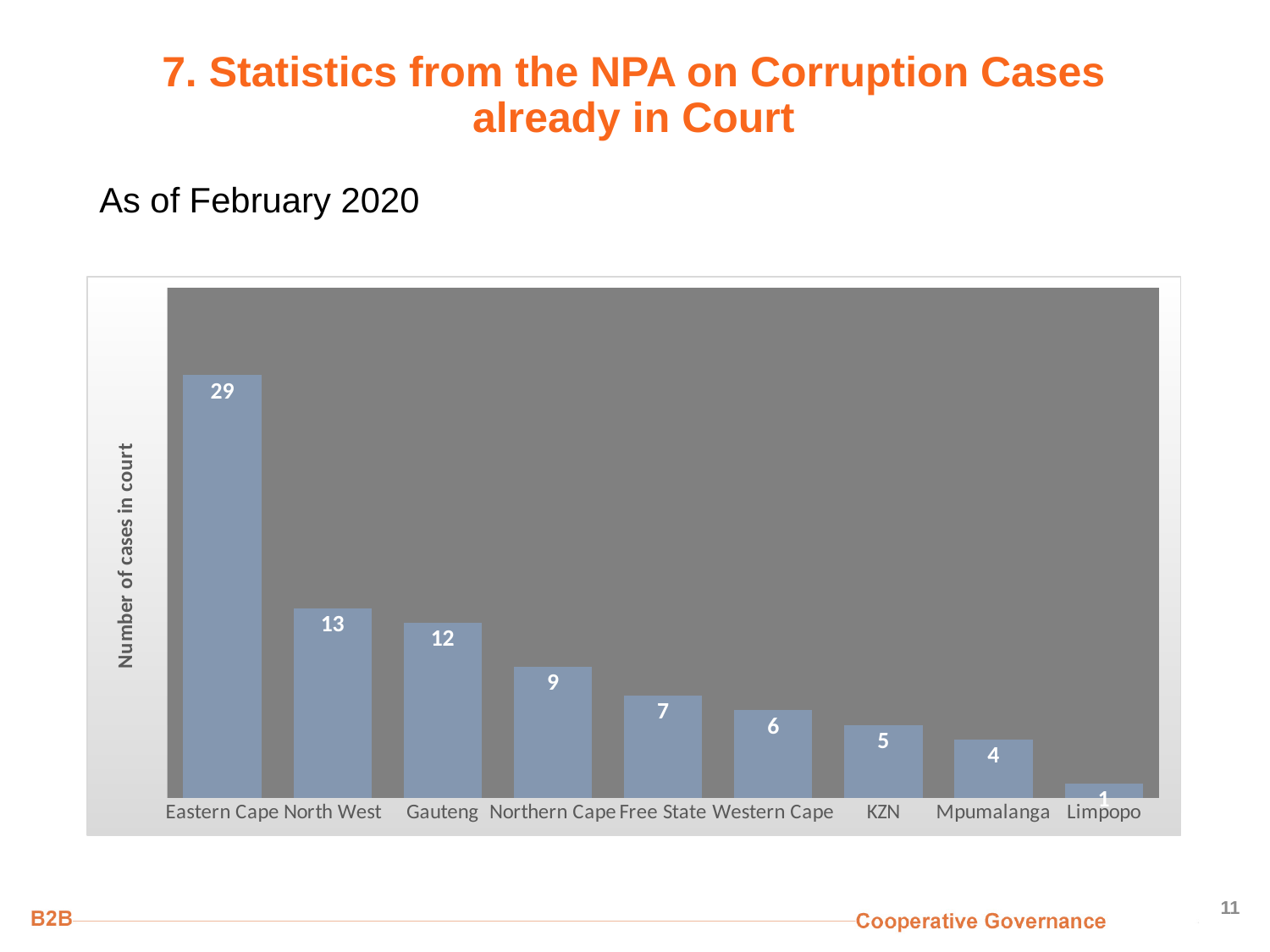
Which has more cases in court, Western Cape or Mpumalanga? Western Cape What kind of chart is shown on the slide? Bar chart What is the label of the vertical axis of the chart? Number of cases in court What is the number of cases in court for Gauteng? 12 Which province has the highest number of cases in court? Eastern Cape What is the difference in the number of cases in court between Northern Cape and Free State? 2 What is the difference in the number of cases in court between Eastern Cape and North West? 16 How many corruption cases in court does the chart show for Eastern Cape? 29 Which province has the lowest number of cases in court? Limpopo What is the number of cases in court for KZN? 5 How many provinces are shown on the x axis of the chart? 9 Do the values rise or fall moving from left to right along the x axis? Fall